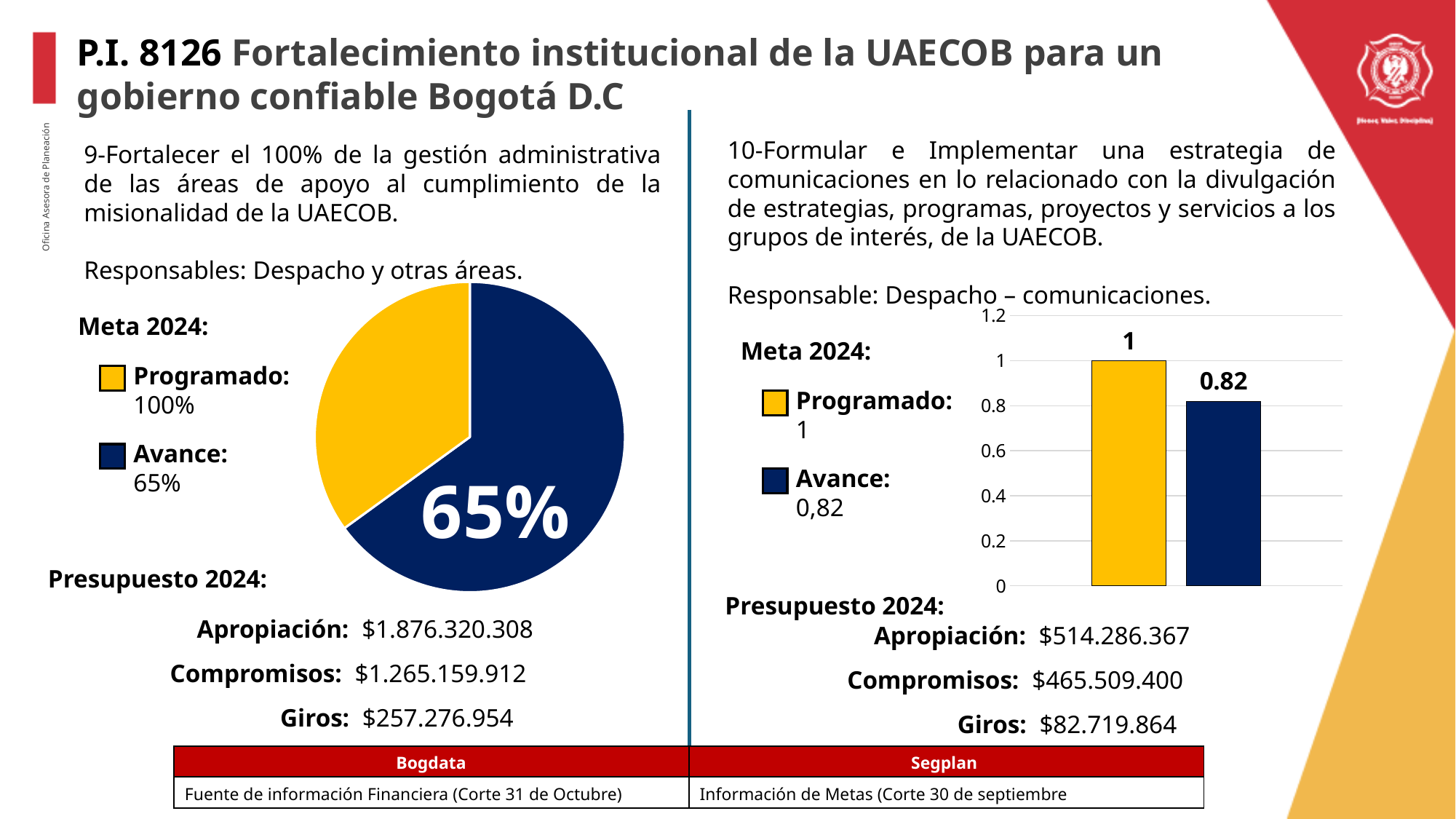
What kind of chart is shown on the right side of the slide, under 'Meta 2024' for goal 10? bar chart In the bar chart on the right, what is the value of the yellow bar (Programado)? 1 What kind of chart is shown on the left side of the slide, under 'Meta 2024' for goal 9? pie chart In the pie chart on the left, which colour represents 'Avance' according to the legend? dark blue In the bar chart on the right, what is the value of the dark blue bar (Avance)? 0.82 In the pie chart on the left, what value is printed on the dark blue slice? 65% In the bar chart on the right, is the value of the Avance bar greater or less than 0.6? greater In the bar chart on the right, what is the difference between the Programado bar and the Avance bar? 0.18 In the pie chart on the left, which slice is larger, the dark blue one or the yellow one? dark blue How many bars are plotted in the bar chart on the right? 2 How many slices does the pie chart on the left have? 2 In the bar chart on the right, which bar is the highest? Programado (yellow bar)